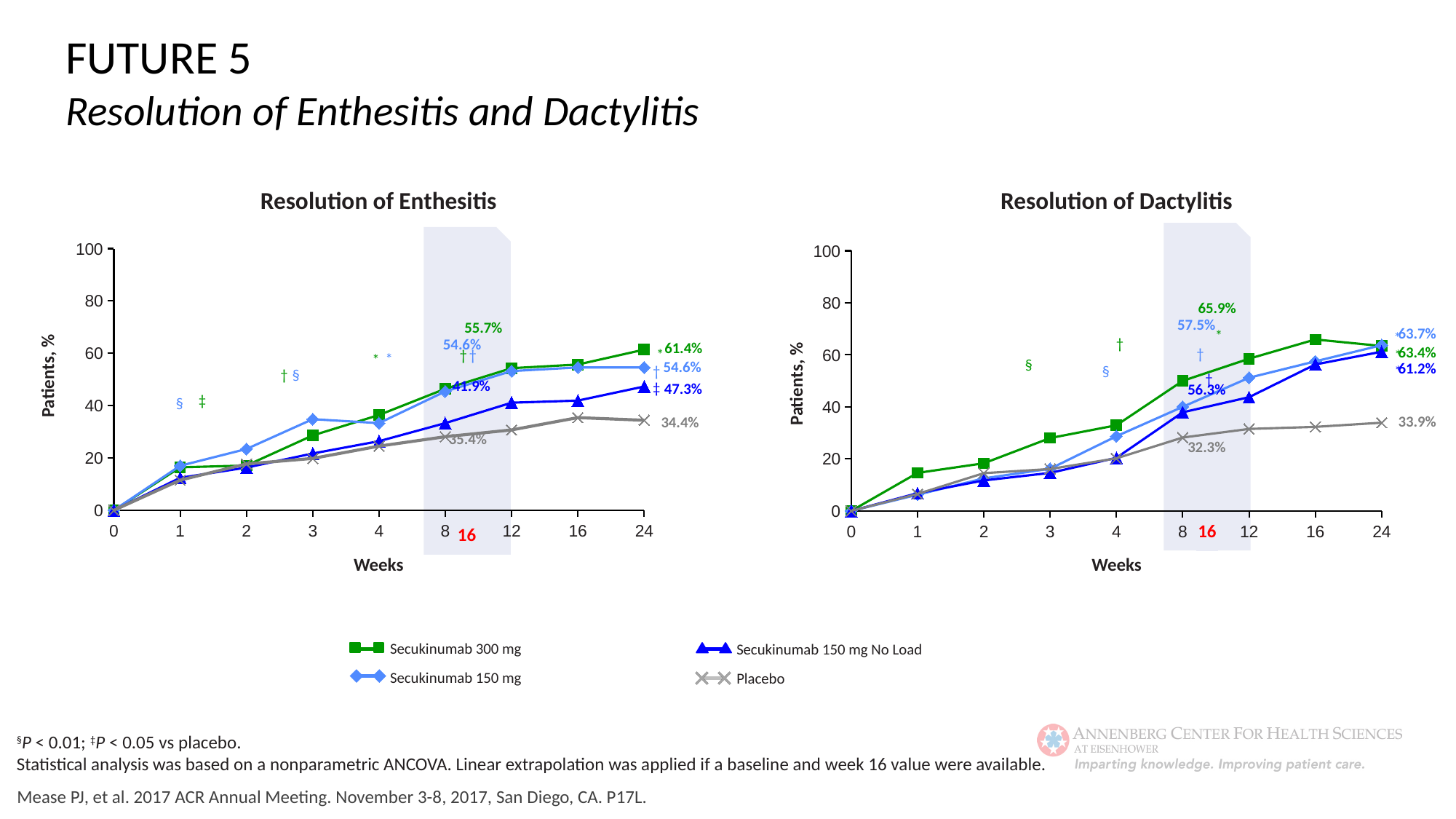
In the Resolution of Enthesitis chart, which is larger at week 24: Secukinumab 150 mg or Secukinumab 150 mg No Load? Secukinumab 150 mg In the Resolution of Enthesitis chart, what is the value for Placebo at week 24? 34.4% How many series does the legend list for the charts? 4 What is the y-axis label on the Resolution of Dactylitis chart? Patients, % What kind of chart is the Resolution of Enthesitis chart? Line chart In the Resolution of Dactylitis chart, what is the value for Placebo at week 24? 33.9% In the Resolution of Dactylitis chart, what is the value for Secukinumab 150 mg No Load at week 24? 61.2% In the Resolution of Enthesitis chart, what is the value for Secukinumab 300 mg at week 24? 61.4% In the Resolution of Dactylitis chart, what is the value for Secukinumab 150 mg at week 24? 63.7% In the Resolution of Dactylitis chart, which series has the lowest value at week 24? Placebo In the Resolution of Enthesitis chart, which series has the highest value at week 24? Secukinumab 300 mg In the Resolution of Enthesitis chart, what is the difference between Secukinumab 300 mg and Placebo at week 24? 27.0 percentage points